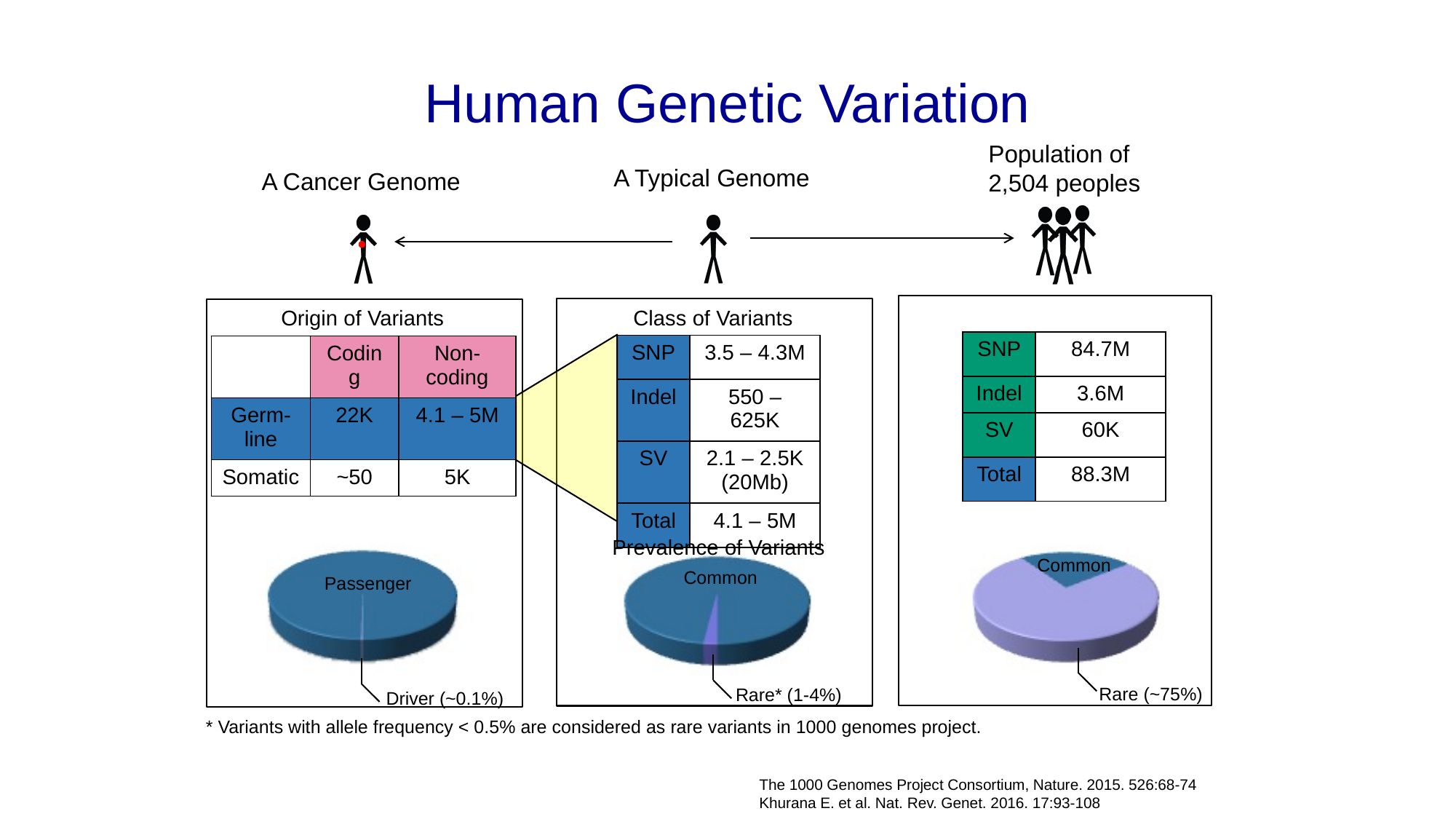
What kind of chart is shown at the bottom of the 'A Cancer Genome' panel? pie chart In the 'Population of 2,504 peoples' pie chart, which slice is the smallest? Common In the 'Population of 2,504 peoples' pie chart, which slice is larger, Common or Rare? Rare In the 'A Cancer Genome' pie chart, what is the label of the small slice? Driver (~0.1%) What kind of chart is shown under 'Prevalence of Variants' in the 'A Typical Genome' panel? pie chart In the 'Population of 2,504 peoples' pie chart, how many slices are labelled? 2 In the 'A Typical Genome' pie chart, how many slices are labelled? 2 In the 'A Cancer Genome' pie chart, which slice is larger, Passenger or Driver? Passenger What kind of chart is shown at the bottom of the 'Population of 2,504 peoples' panel? pie chart In the 'A Cancer Genome' pie chart, how many slices are labelled? 2 In the 'A Typical Genome' pie chart, which slice is larger, Common or Rare? Common What is the title printed above the pie chart in the 'A Typical Genome' panel? Prevalence of Variants